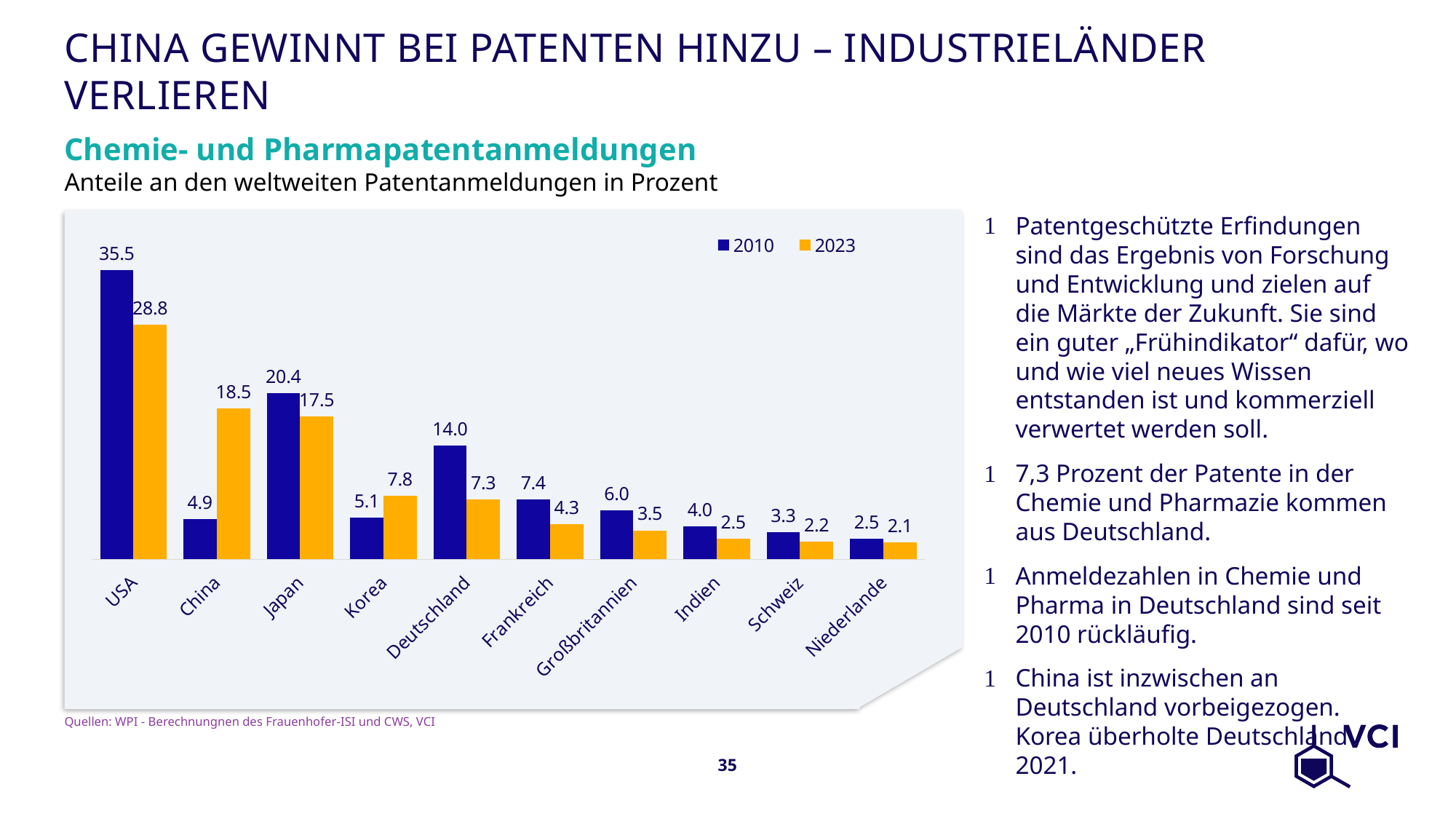
How many series does the legend list? 2 Which colour represents the year 2023 in the chart? Orange Which country had the highest share in 2023? USA Which country had the lowest share in 2010? Niederlande By how much did China's share rise from 2010 to 2023? 13.6 Which was larger in 2023: Korea's share or Deutschland's share? Korea How many countries are shown on the chart? 10 What was China's share of chemical and pharma patent applications in 2023? 18.5 What was Deutschland's share in 2023? 7.3 By how much did the USA's share fall from 2010 to 2023? 6.7 What was the USA's share of chemical and pharma patent applications in 2010? 35.5 What kind of chart is shown on the slide? Bar chart